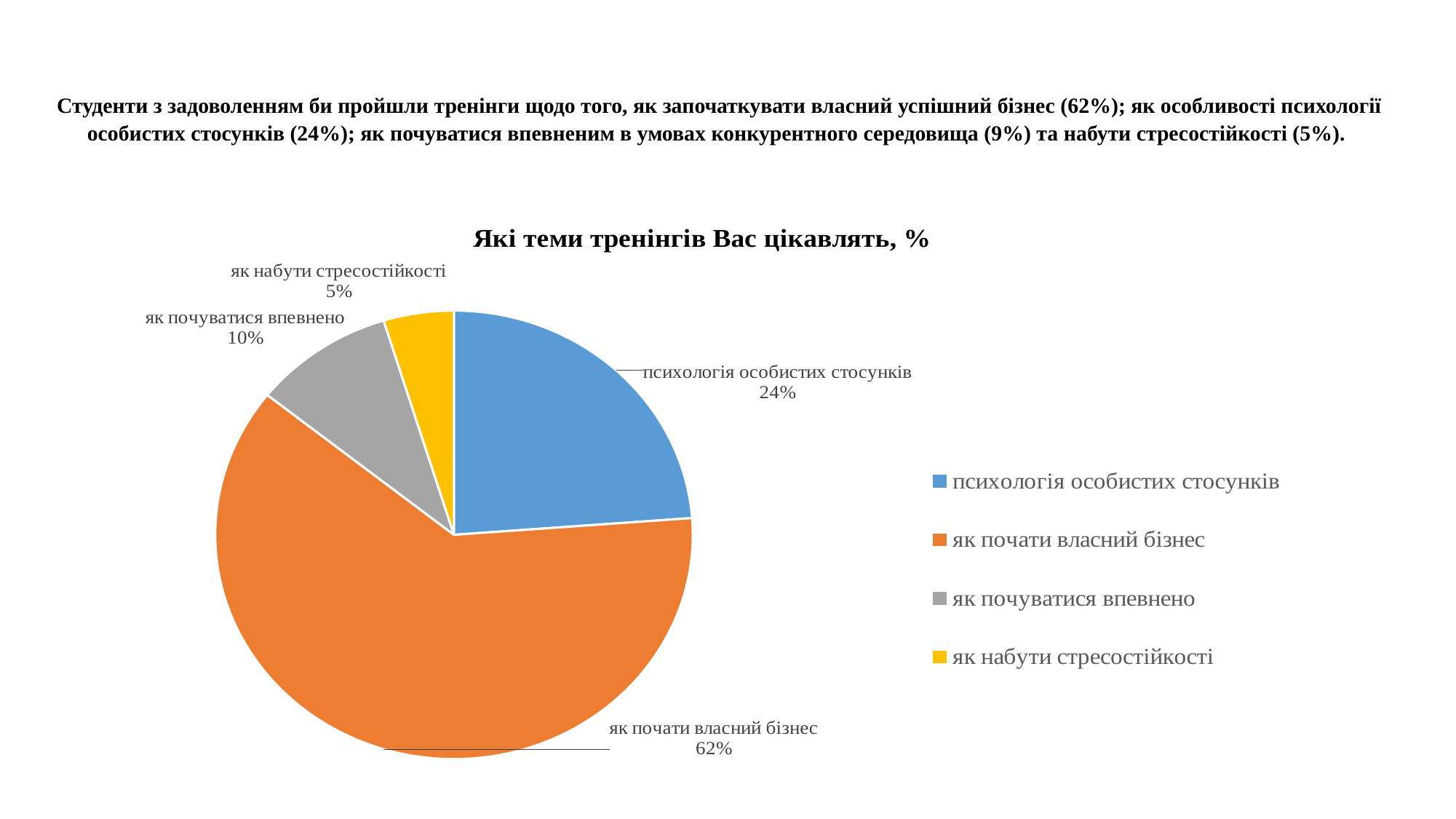
Which category has the smallest slice of the pie? як набути стресостійкості How many categories are shown in the pie chart? 4 What share of the pie does "як набути стресостійкості" have? 5% What colour is the slice for "як набути стресостійкості"? yellow What is the title of the chart? Які теми тренінгів Вас цікавлять, % Which is larger: the share for "як почуватися впевнено" or the share for "як набути стресостійкості"? як почуватися впевнено What share of the pie does "як почуватися впевнено" have? 10% What type of chart is shown on the slide? pie chart Which category has the largest slice of the pie? як почати власний бізнес What is the difference in percentage points between "як почати власний бізнес" and "психологія особистих стосунків"? 38 What share of the pie does "психологія особистих стосунків" have? 24%